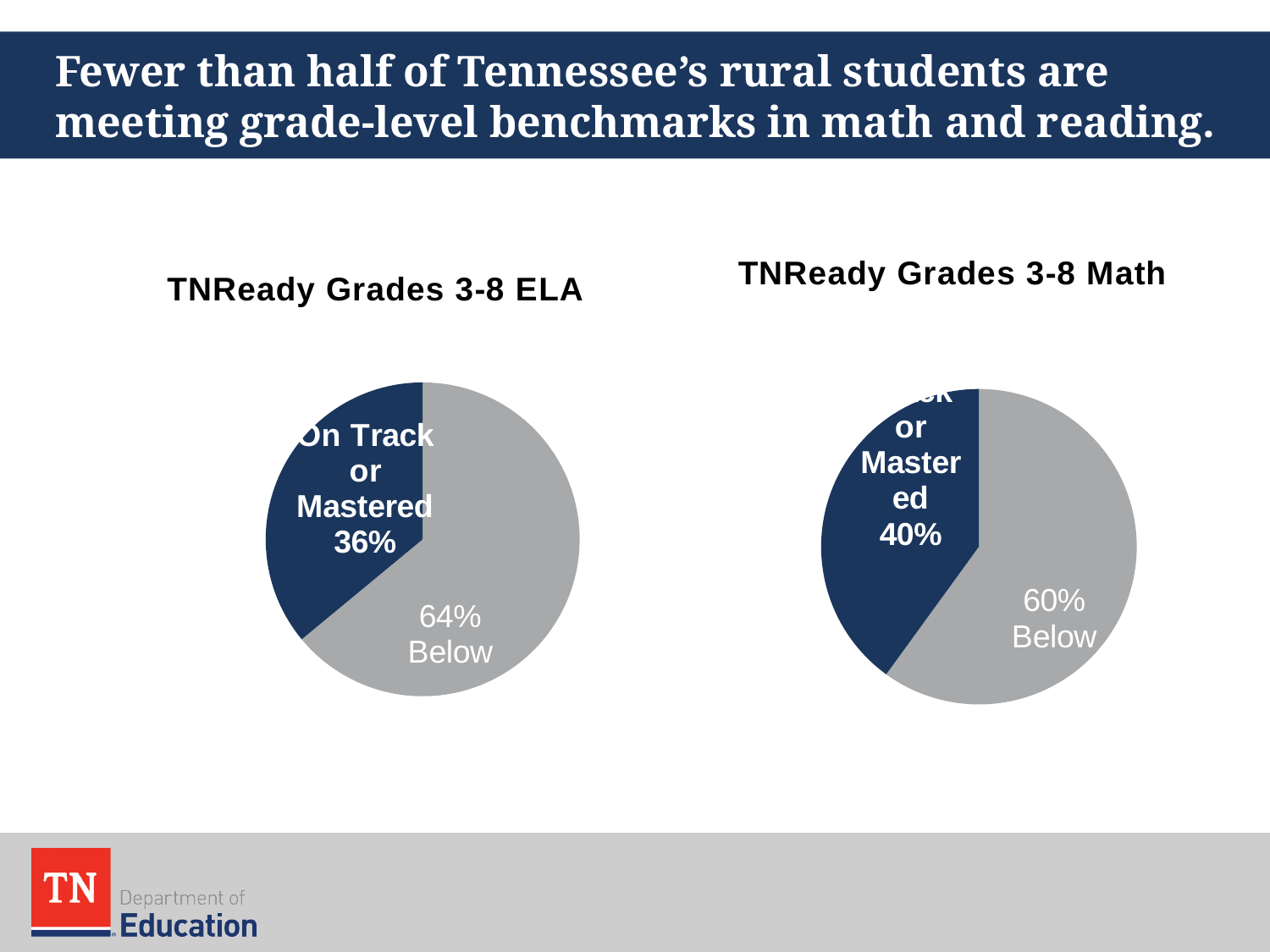
Which chart shows a larger On Track or Mastered share, TNReady Grades 3-8 ELA or TNReady Grades 3-8 Math? TNReady Grades 3-8 Math In the TNReady Grades 3-8 Math chart, which slice is the smallest? On Track or Mastered In the TNReady Grades 3-8 ELA chart, what percentage of students are On Track or Mastered? 36% In the TNReady Grades 3-8 ELA chart, what colour is the On Track or Mastered slice? Dark blue In the TNReady Grades 3-8 Math chart, what percentage of students are Below? 60% In the TNReady Grades 3-8 ELA chart, what is the difference between the Below share and the On Track or Mastered share? 28% In the TNReady Grades 3-8 ELA chart, what percentage of students are Below? 64% How many slices does the TNReady Grades 3-8 Math pie chart have? 2 In the TNReady Grades 3-8 Math chart, what is the difference between the Below share and the On Track or Mastered share? 20% In the TNReady Grades 3-8 Math chart, what percentage of students are On Track or Mastered? 40% In the TNReady Grades 3-8 ELA chart, which slice is the largest? Below What kind of chart is the TNReady Grades 3-8 ELA chart? Pie chart